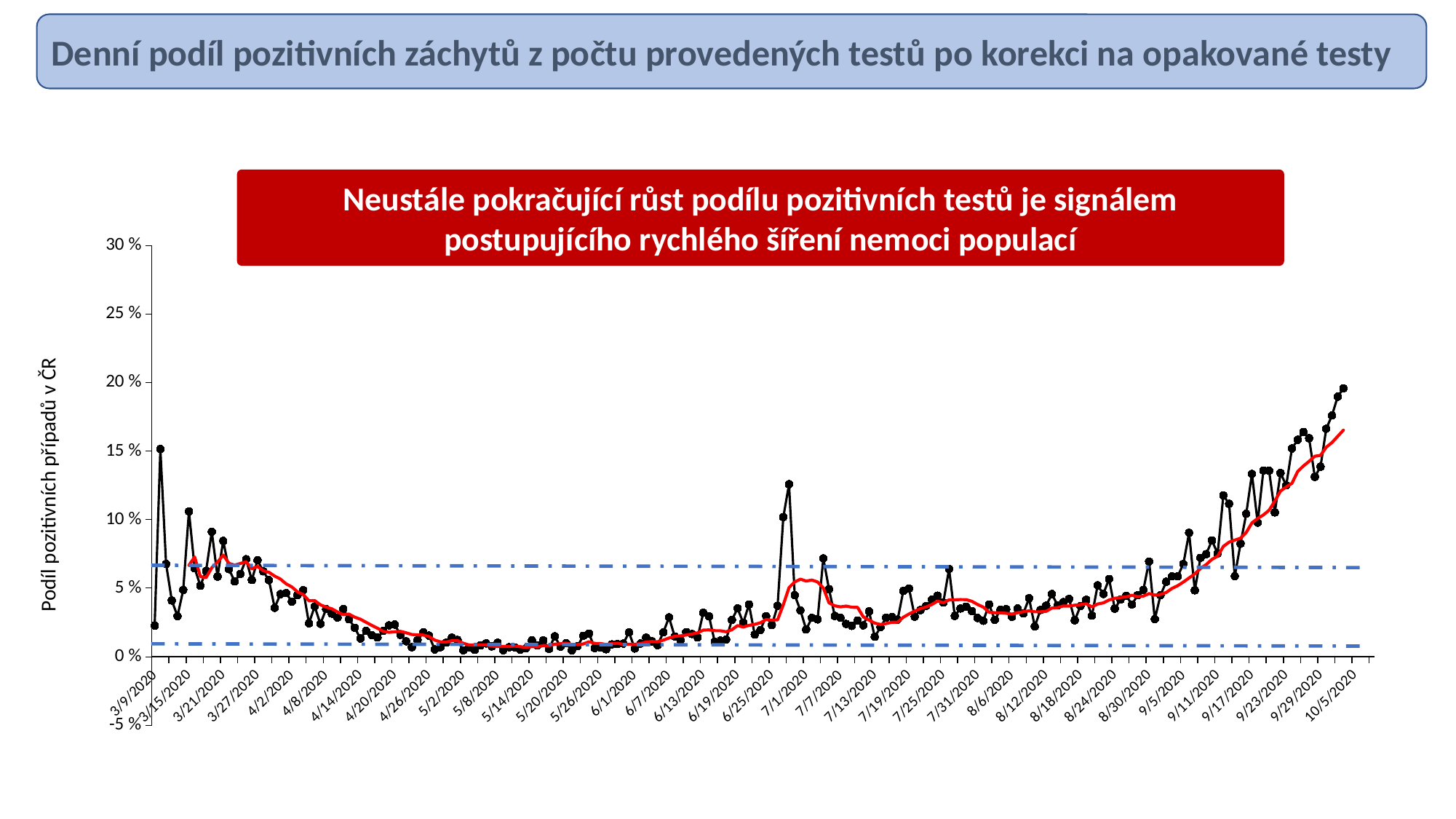
What is the title of the chart on the slide? Denní podíl pozitivních záchytů z počtu provedených testů po korekci na opakované testy Is the highest black point between 6/25/2020 and 7/1/2020 greater or less than 10 %? greater Is the value of the black dotted series at 3/9/2020 greater or less than 5 %? less What is the label of the vertical axis? Podíl pozitivních případů v ČR Does the black dotted series rise or fall between 8/30/2020 and 10/5/2020? rise Is the value of the black dotted series at 5/8/2020 greater or less than 5 %? less Which is larger: the black series value at 5/8/2020 or the peak near 7/1/2020? the peak near 7/1/2020 What kind of chart is shown on the slide? line chart Does the black dotted series rise or fall between 3/27/2020 and 5/2/2020? fall